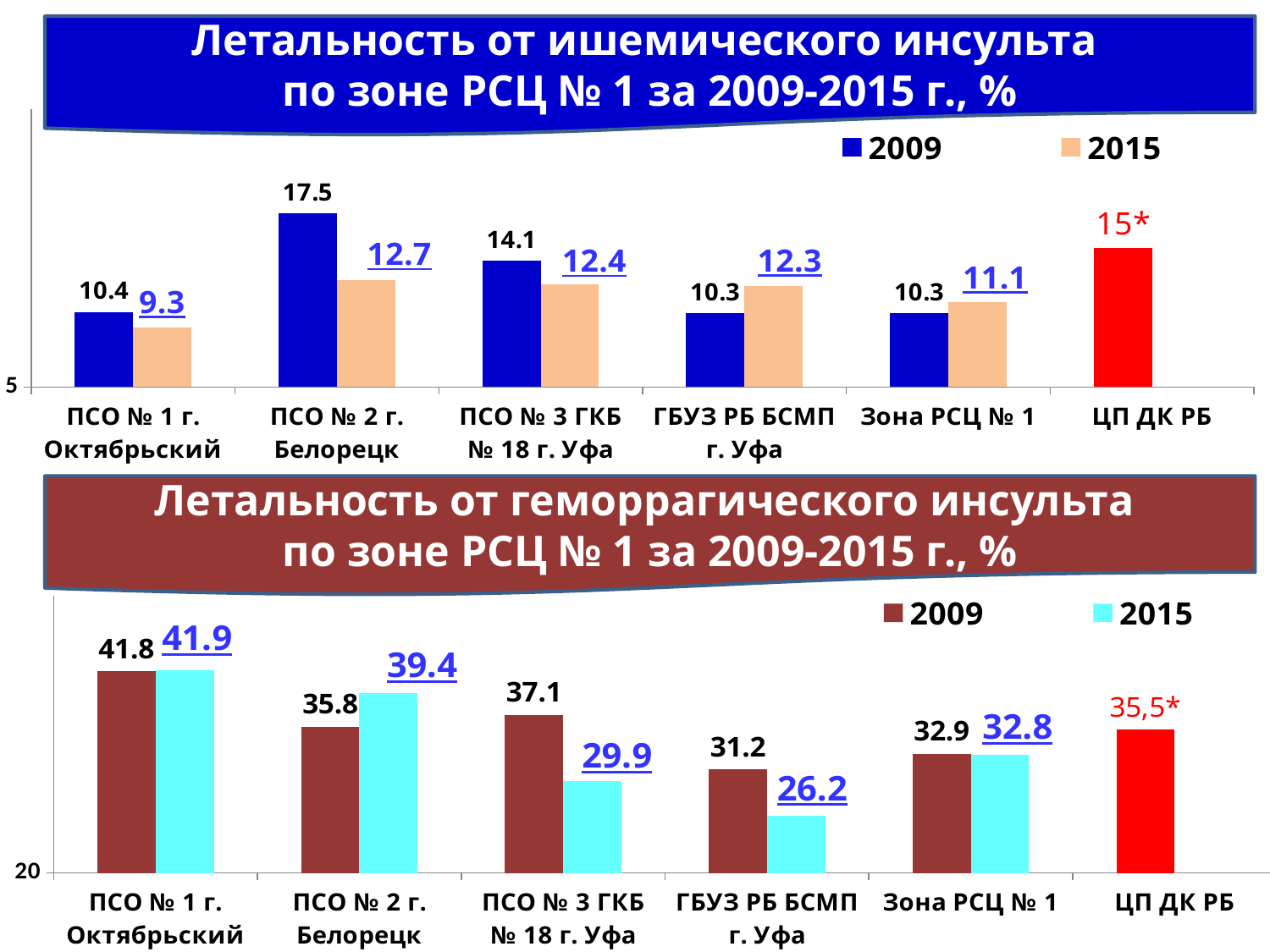
In the top chart (ischemic stroke mortality), what is the 2015 value for ГБУЗ РБ БСМП г. Уфа? 12.3 How many series does the legend of the bottom chart (hemorrhagic stroke mortality) list? 2 In the top chart (ischemic stroke mortality), which category has the highest 2009 value? ПСО № 2 г. Белорецк In the top chart (ischemic stroke mortality), which category has the lowest 2015 value? ПСО № 1 г. Октябрьский In the top chart (ischemic stroke mortality), what is the 2009 value for ПСО № 2 г. Белорецк? 17.5 What type of chart is the top chart (ischemic stroke mortality)? Bar chart In the bottom chart (hemorrhagic stroke mortality), which category has the lowest 2015 value? ГБУЗ РБ БСМП г. Уфа In the bottom chart (hemorrhagic stroke mortality), what is the difference between the 2009 and 2015 values for ГБУЗ РБ БСМП г. Уфа? 5.0 In the top chart (ischemic stroke mortality), what is the difference between the 2009 and 2015 values for ПСО № 2 г. Белорецк? 4.8 In the bottom chart (hemorrhagic stroke mortality), which is larger for ПСО № 2 г. Белорецк: the 2009 value or the 2015 value? 2015 In the top chart (ischemic stroke mortality), what value is shown for ЦП ДК РБ? 15* In the bottom chart (hemorrhagic stroke mortality), what is the 2015 value for ПСО № 3 ГКБ № 18 г. Уфа? 29.9